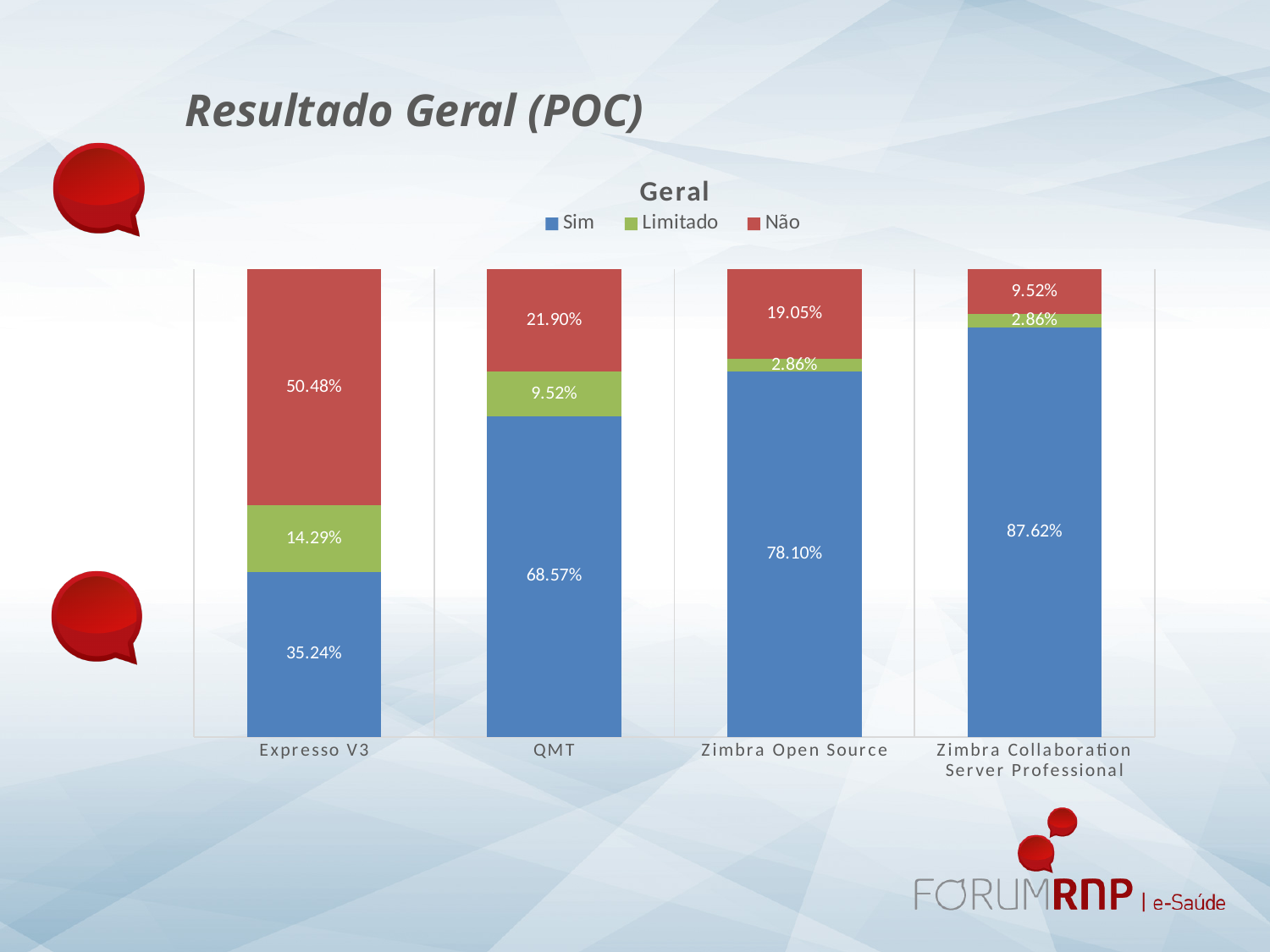
What kind of chart is shown on the slide? Stacked bar chart Which is larger: the "Não" value for QMT or the "Não" value for Zimbra Open Source? QMT Which category has the highest "Sim" value? Zimbra Collaboration Server Professional What is the "Não" value for Expresso V3 in the Geral chart? 50.48% How many series does the legend of the Geral chart list? 3 Which category has the lowest "Não" value? Zimbra Collaboration Server Professional What is the "Sim" value for Zimbra Open Source in the Geral chart? 78.10% What is the "Limitado" value for QMT in the Geral chart? 9.52% What is the difference between the "Sim" values for QMT and Expresso V3? 33.33% What is the "Sim" value for Zimbra Collaboration Server Professional? 87.62% Which series is shown in green in the Geral chart? Limitado How many categories are shown on the x axis of the Geral chart? 4